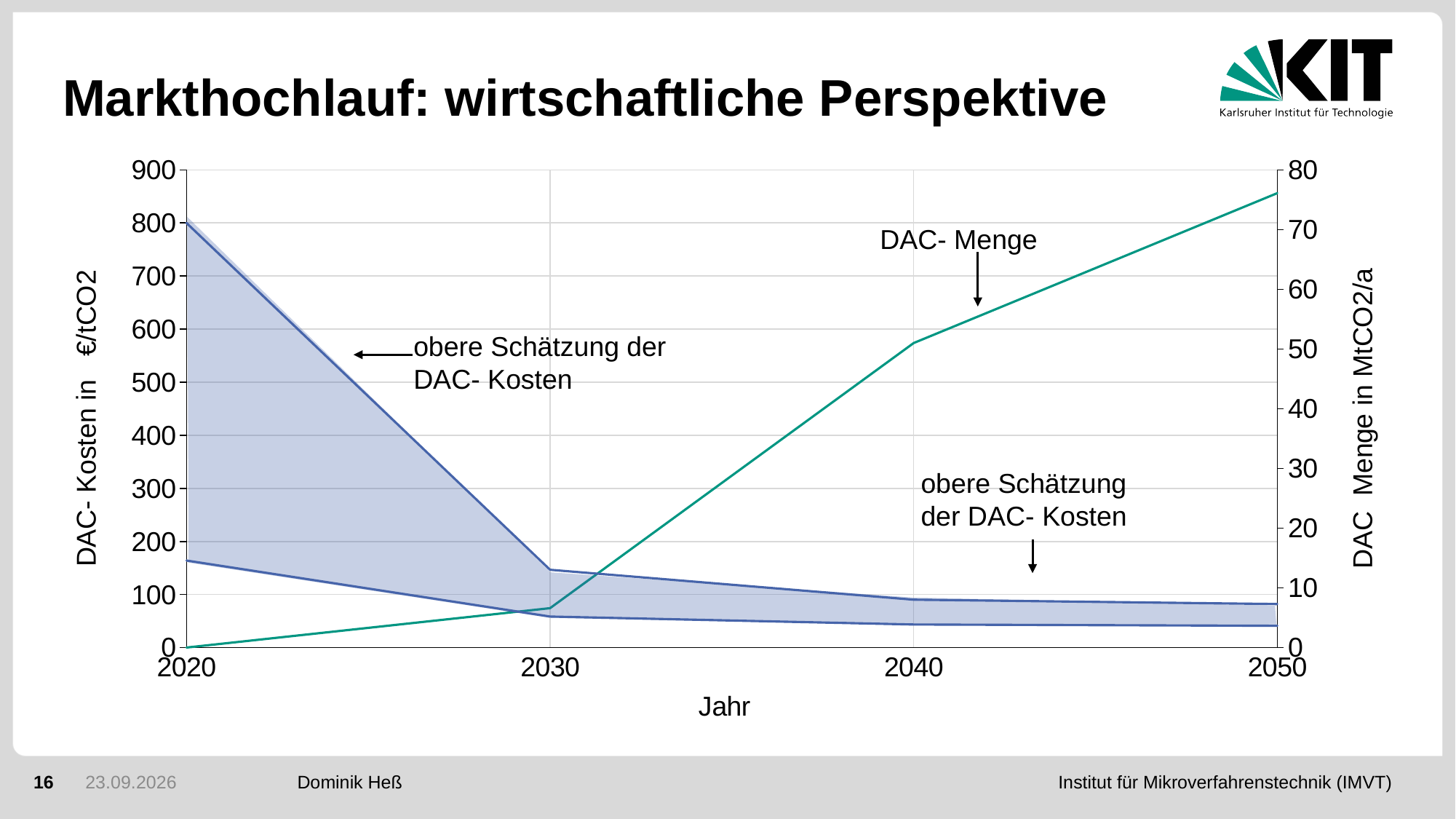
Does the DAC- Menge line rise or fall from 2020 to 2050? rise Is the DAC- Menge value in 2030 greater or less than 10? less What is the label of the x axis? Jahr Is the obere Schätzung der DAC- Kosten value in 2050 greater or less than 100? less What kind of chart is shown on the slide? line chart Does the obere Schätzung der DAC- Kosten line rise or fall from 2020 to 2050? fall Is the obere Schätzung der DAC- Kosten value in 2020 greater or less than 700? greater What is the label of the right-hand y axis? DAC Menge in MtCO2/a How many years are marked on the x axis? 4 Which year has the higher obere Schätzung der DAC- Kosten value, 2020 or 2050? 2020